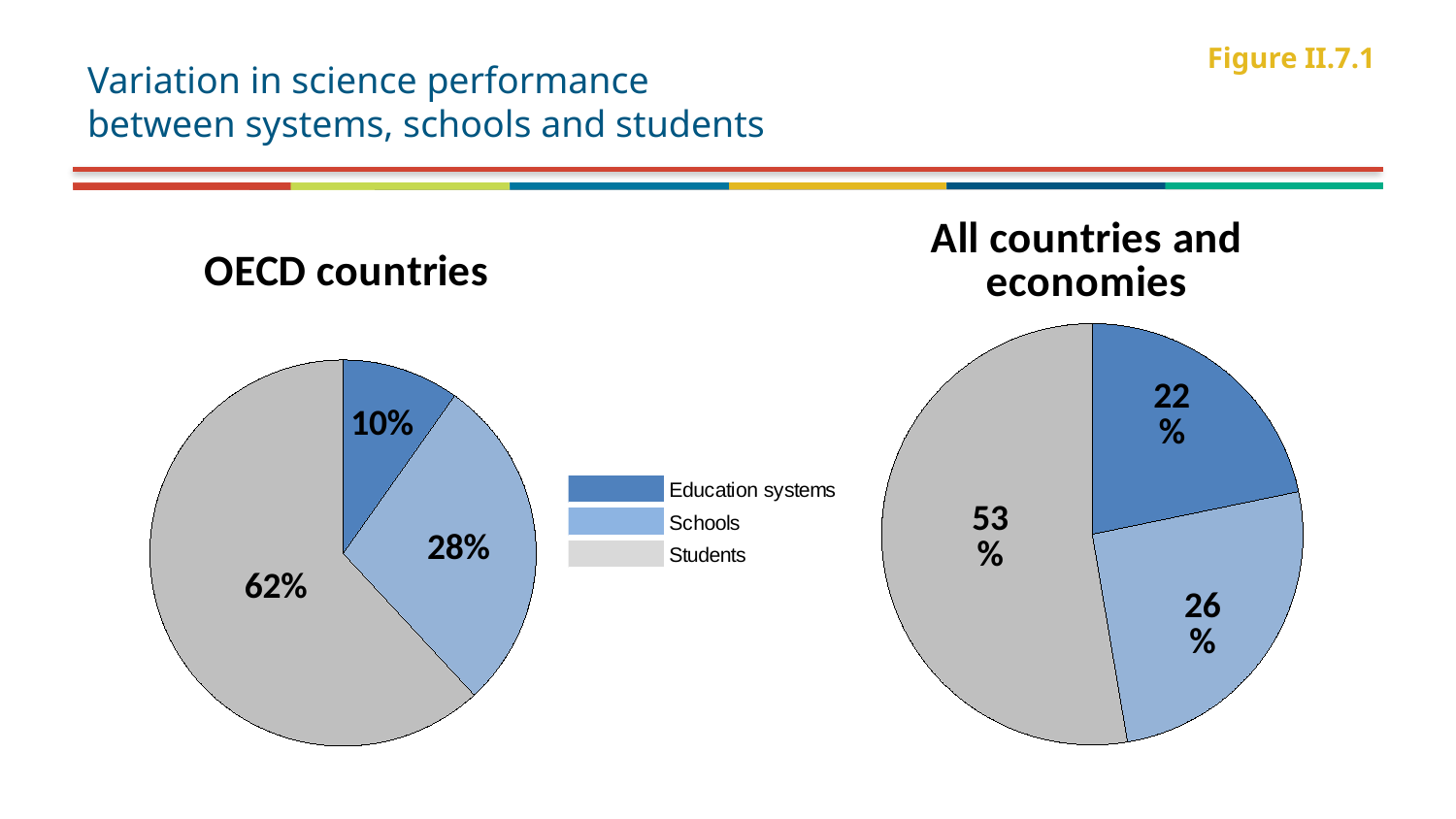
What is the title of the chart on the left? OECD countries In the OECD countries pie chart, what is the difference between the Students share and the Schools share? 34 percentage points In the All countries and economies pie chart, which category has the largest slice? Students What type of chart is used on this slide? Pie chart In the OECD countries pie chart, what share is attributed to Education systems? 10% Is the Education systems share larger in the OECD countries chart or in the All countries and economies chart? All countries and economies How many categories does the legend list? 3 In the OECD countries pie chart, what share is attributed to Students? 62% In the OECD countries pie chart, what share is attributed to Schools? 28% In the All countries and economies pie chart, what share is attributed to Students? 53% In the OECD countries pie chart, which category has the smallest slice? Education systems In the All countries and economies pie chart, what share is attributed to Education systems? 22%